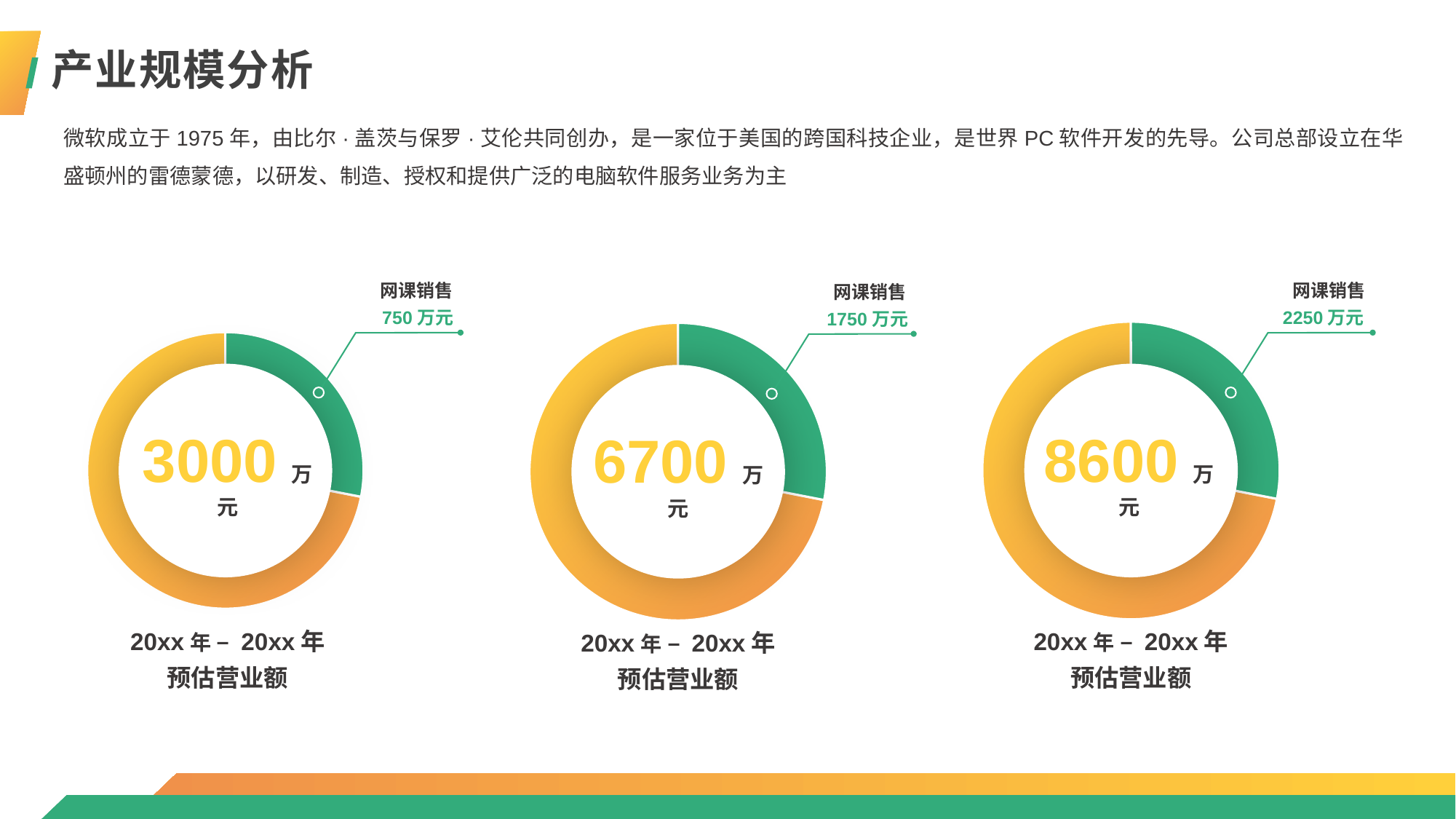
In the right donut chart, what is the value labelled for 网课销售? 2250 万元 What kind of charts are shown on the slide? Donut charts In the middle donut chart, what is the value shown in the centre? 6700 万元 In the left donut chart, what is the value shown in the centre? 3000 万元 How many segments does each donut chart have? 2 What is the difference between the 网课销售 values of the right and left donut charts? 1500 万元 How many donut charts are on the slide? 3 Is the centre value of the middle donut chart larger or smaller than that of the left donut chart? Larger In the middle donut chart, what is the value labelled for 网课销售? 1750 万元 Which donut chart has the highest 网课销售 value? The right chart (2250 万元) In the left donut chart, what is the value labelled for 网课销售? 750 万元 In the right donut chart, what is the value shown in the centre? 8600 万元